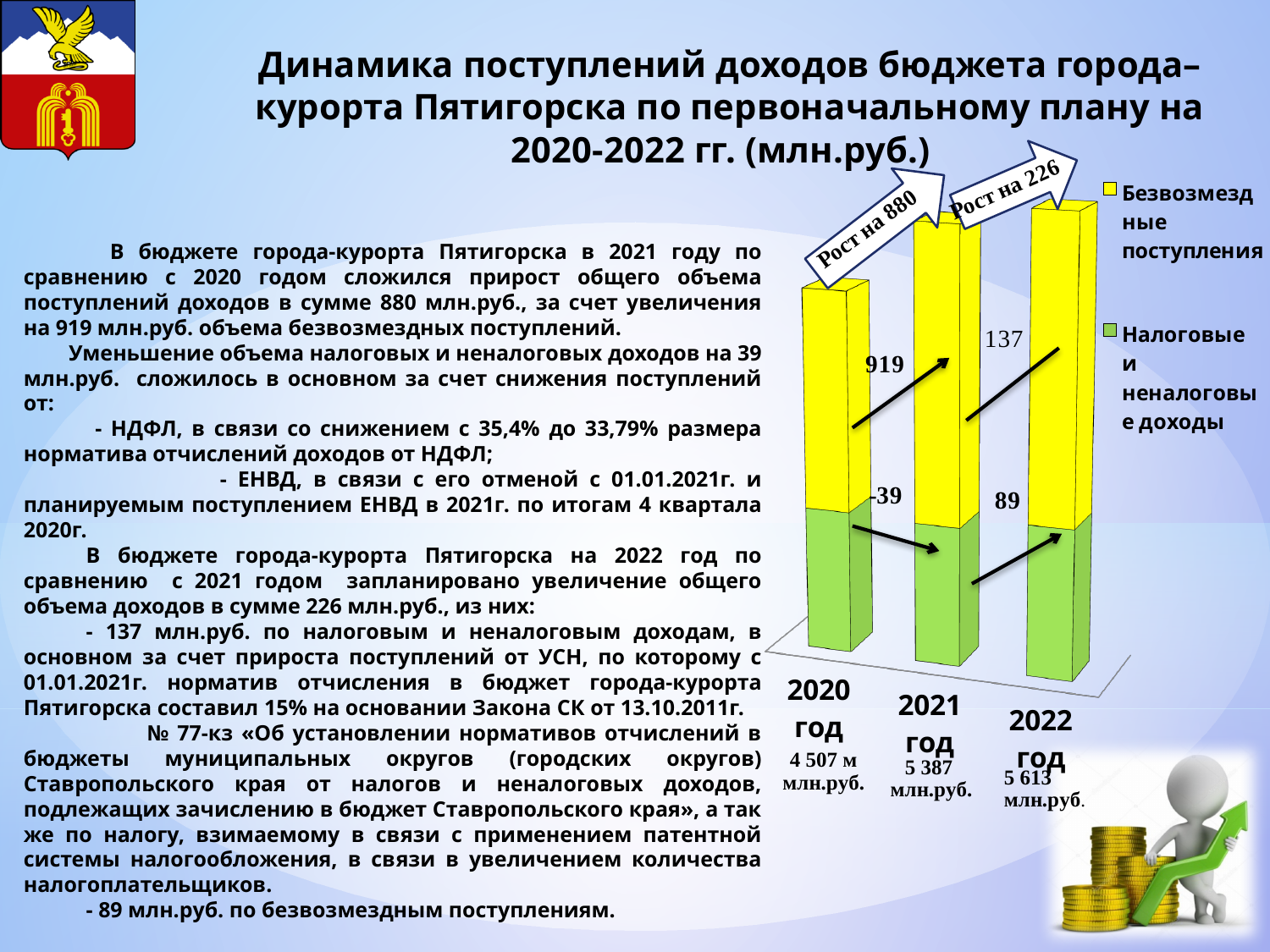
Do the total revenues rise or fall from 2020 to 2022? Rise Which is larger: the total revenue for 2021 or for 2022? 2022 Which year has the highest total revenue on the chart? 2022 год What is the total budget revenue shown for 2022 год? 5 613 млн.руб. What kind of chart is shown on the slide? Stacked bar chart Which year has the lowest total revenue on the chart? 2020 год What is the total budget revenue shown for 2020 год? 4 507 млн.руб. Which series is shown in yellow in the chart legend? Безвозмездные поступления How many years (categories) are shown on the chart? 3 By how much does the total revenue for 2021 exceed that for 2020, according to the chart? 880 млн.руб. How many series does the chart legend list? 2 What is the total budget revenue shown for 2021 год? 5 387 млн.руб.